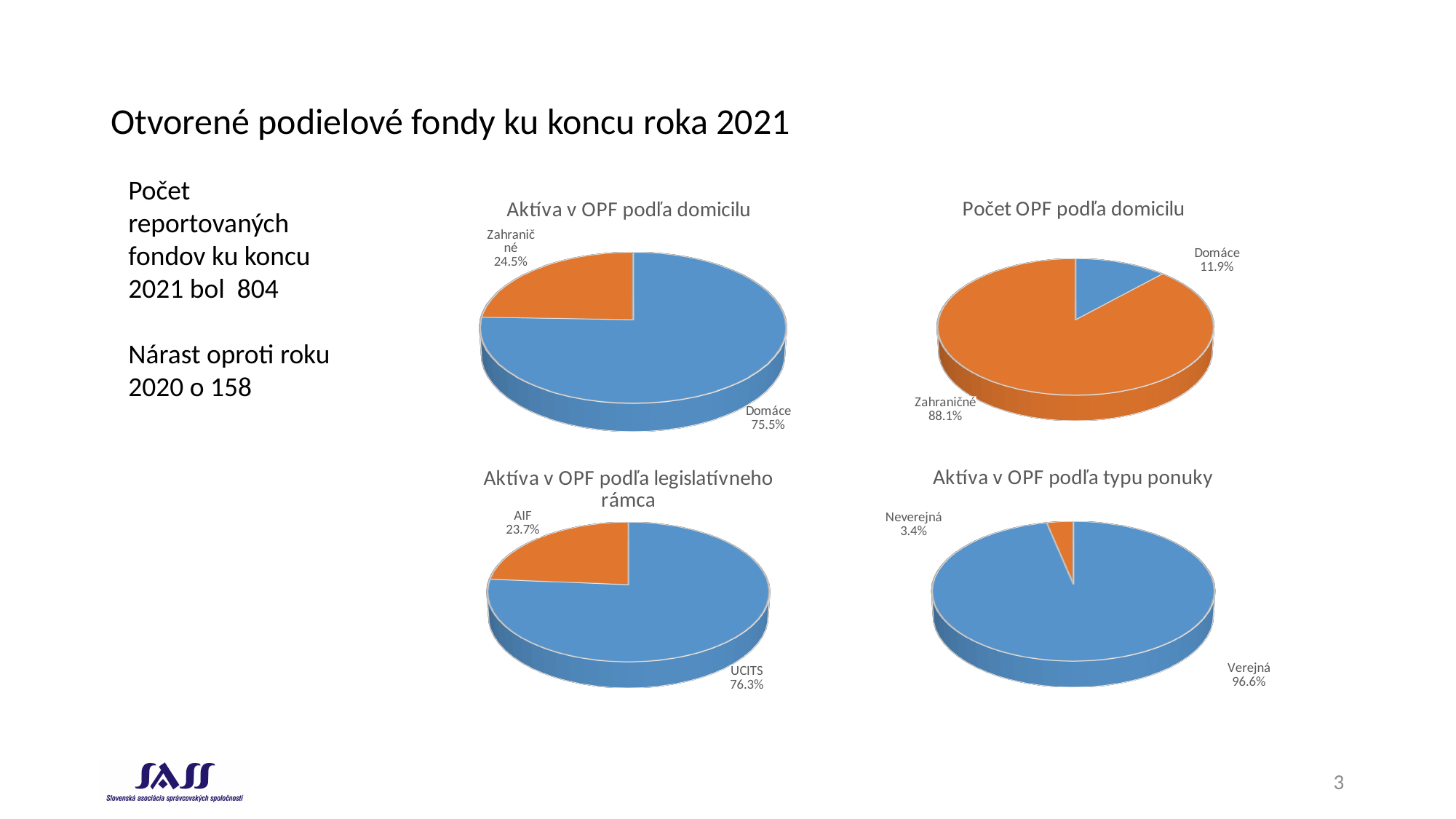
In the chart titled "Aktíva v OPF podľa domicilu", what share does Zahraničné have? 24.5% In the chart titled "Aktíva v OPF podľa domicilu", what is the difference between the Domáce and Zahraničné shares? 51.0% How many slices does the chart titled "Aktíva v OPF podľa typu ponuky" have? 2 In the chart titled "Aktíva v OPF podľa typu ponuky", what is the difference between the Verejná and Neverejná shares? 93.2% In the chart titled "Počet OPF podľa domicilu", which slice is the smallest? Domáce In the chart titled "Aktíva v OPF podľa typu ponuky", what share does Neverejná have? 3.4% What kind of chart is "Počet OPF podľa domicilu"? Pie chart How many pie charts are shown on the slide? 4 In the chart titled "Aktíva v OPF podľa domicilu", what share does Domáce have? 75.5% In the chart titled "Aktíva v OPF podľa legislatívneho rámca", what share does AIF have? 23.7% In the chart titled "Aktíva v OPF podľa legislatívneho rámca", which slice is the largest? UCITS In the chart titled "Počet OPF podľa domicilu", what share does Zahraničné have? 88.1%